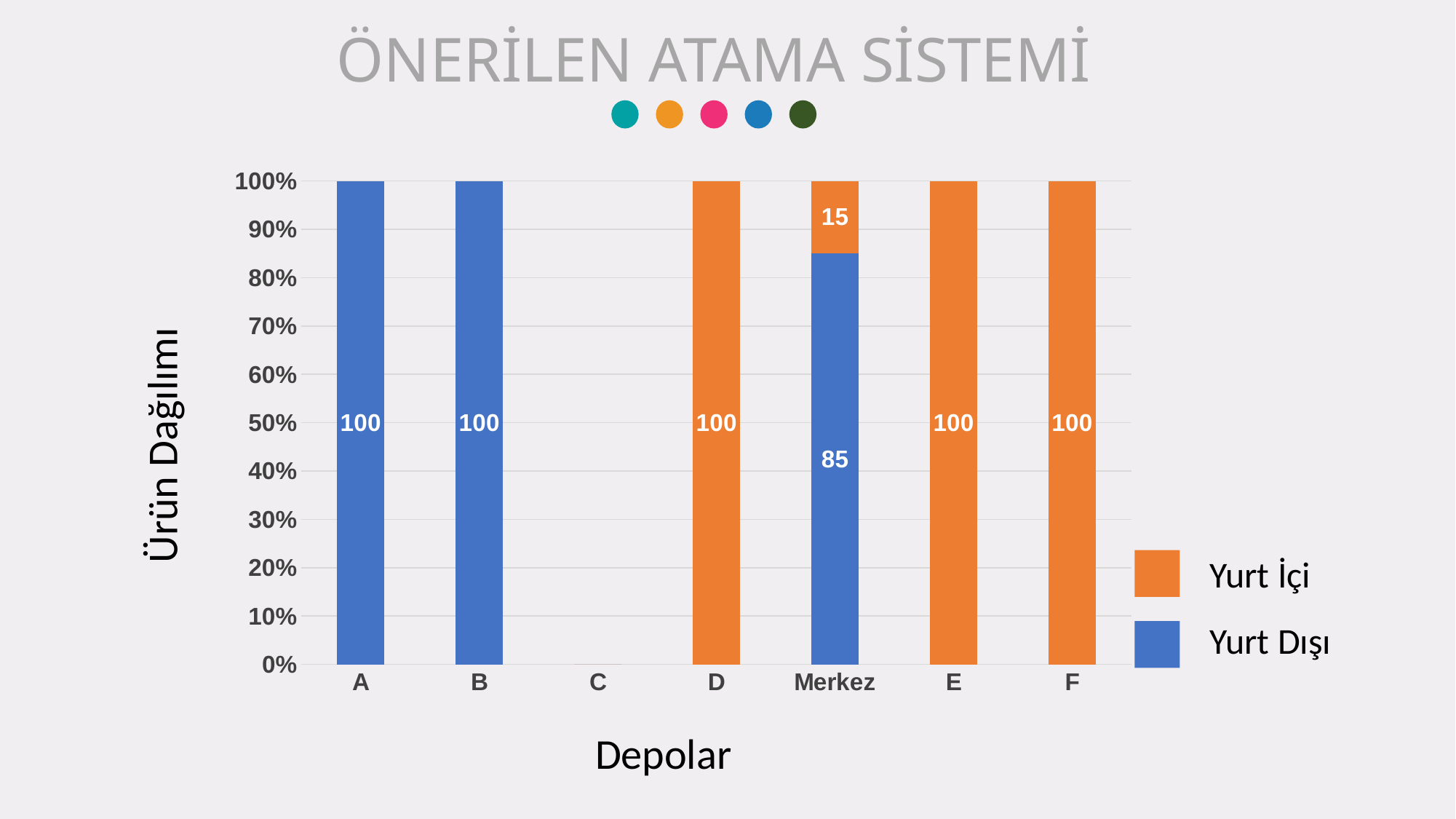
What is the Yurt Dışı value for Merkez? 85 What is the label of the x axis? Depolar What is the difference between the Yurt Dışı and Yurt İçi values for Merkez? 70 For Merkez, which is larger, Yurt Dışı or Yurt İçi? Yurt Dışı What is the Yurt İçi value for Merkez? 15 What is the total of the stacked bar for Merkez? 100 What is the Yurt Dışı value for A? 100 Which category has no bar plotted? C What kind of chart is shown on the slide? Stacked bar chart How many series does the legend list? 2 How many categories are shown on the x axis? 7 What is the Yurt İçi value for F? 100